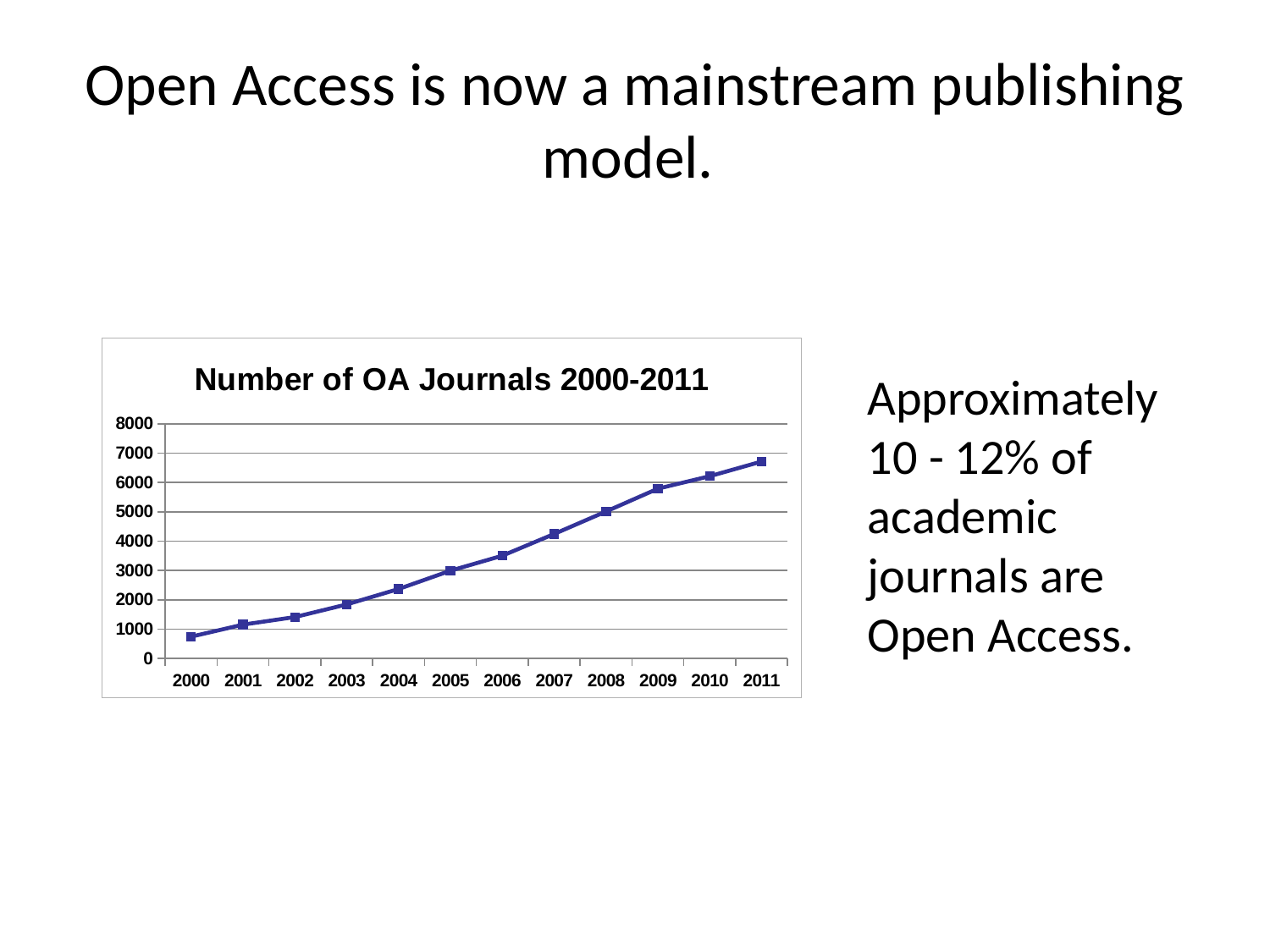
How many years are plotted on the x axis of the chart? 12 What is the highest value shown on the y axis of the chart? 8000 Do the values rise or fall from 2000 to 2011? rise Is the value for 2000 greater or less than 1000? less Is the value for 2007 greater or less than 4000? greater Which year has a larger value, 2004 or 2009? 2009 Which year has the highest number of OA journals? 2011 Is the value for 2003 greater or less than 2000? less What kind of chart is shown on the slide? line chart What is the title of the chart? Number of OA Journals 2000-2011 Which year has the lowest number of OA journals? 2000